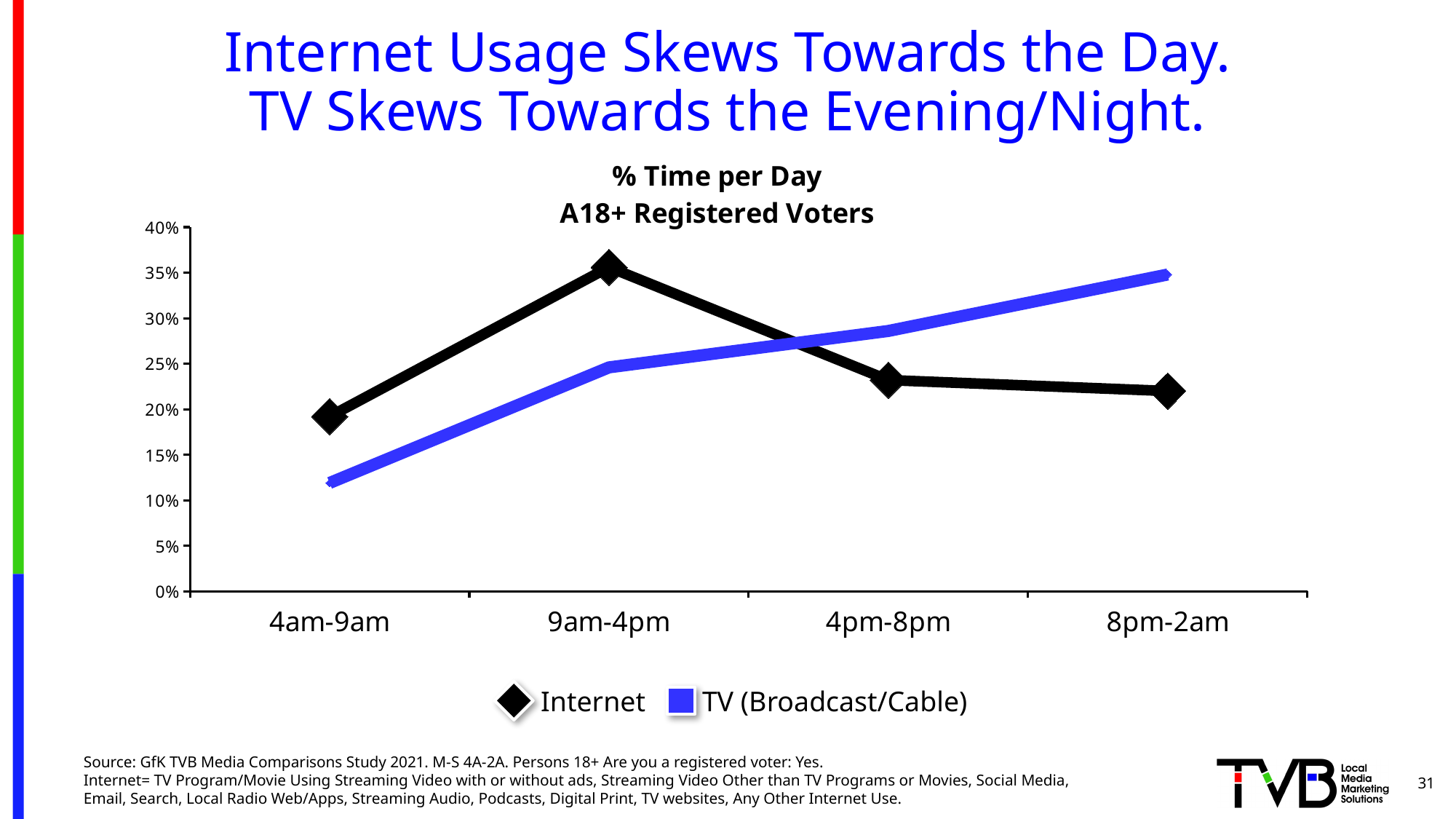
How many series does the legend list? 2 In which time period is the TV (Broadcast/Cable) series lowest? 4am-9am What is the title of the chart? % Time per Day A18+ Registered Voters Is the TV (Broadcast/Cable) value for 4am-9am greater or less than 15%? less How many time periods are shown on the x axis? 4 Is the Internet value for 8pm-2am greater or less than 25%? less In which time period is the TV (Broadcast/Cable) series highest? 8pm-2am Does the TV (Broadcast/Cable) series rise or fall across the time periods from 4am-9am to 8pm-2am? rise In which time period is the Internet series highest? 9am-4pm At 8pm-2am, which series has the higher value, Internet or TV (Broadcast/Cable)? TV (Broadcast/Cable) What kind of chart is shown on the slide? line chart Is the Internet value for 9am-4pm greater or less than 30%? greater